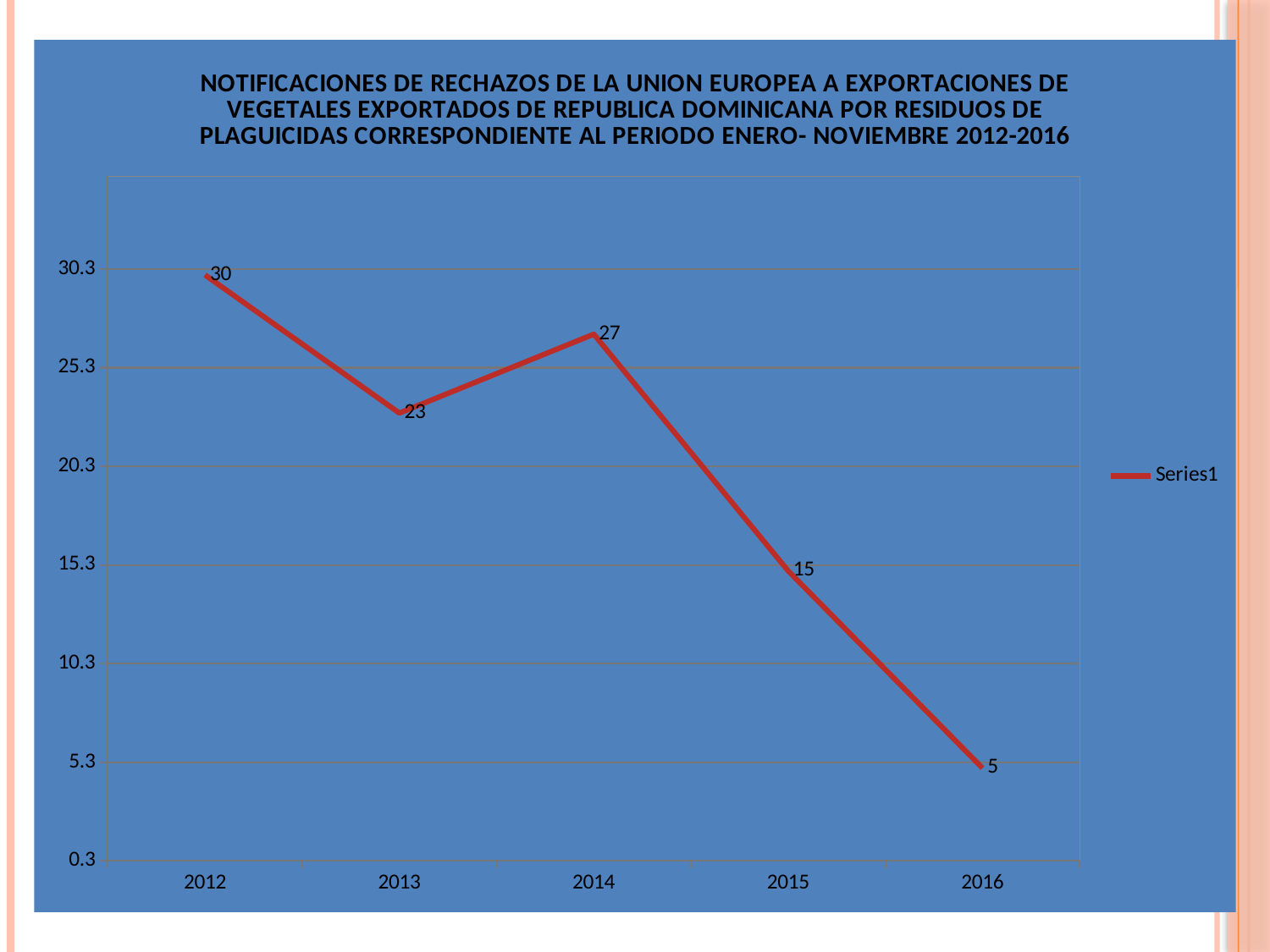
What is the value for 2015? 15 What is the value for 2012? 30 Which year has the highest value? 2012 What kind of chart is shown? line chart What is the difference between the values for 2014 and 2015? 12 Which is larger, the value for 2013 or the value for 2014? 2014 What is the value for 2016? 5 Which year has the lowest value? 2016 How many years are plotted on the x axis? 5 What is the value for 2013? 23 What is the name of the series shown in the legend? Series1 What is the value for 2014? 27